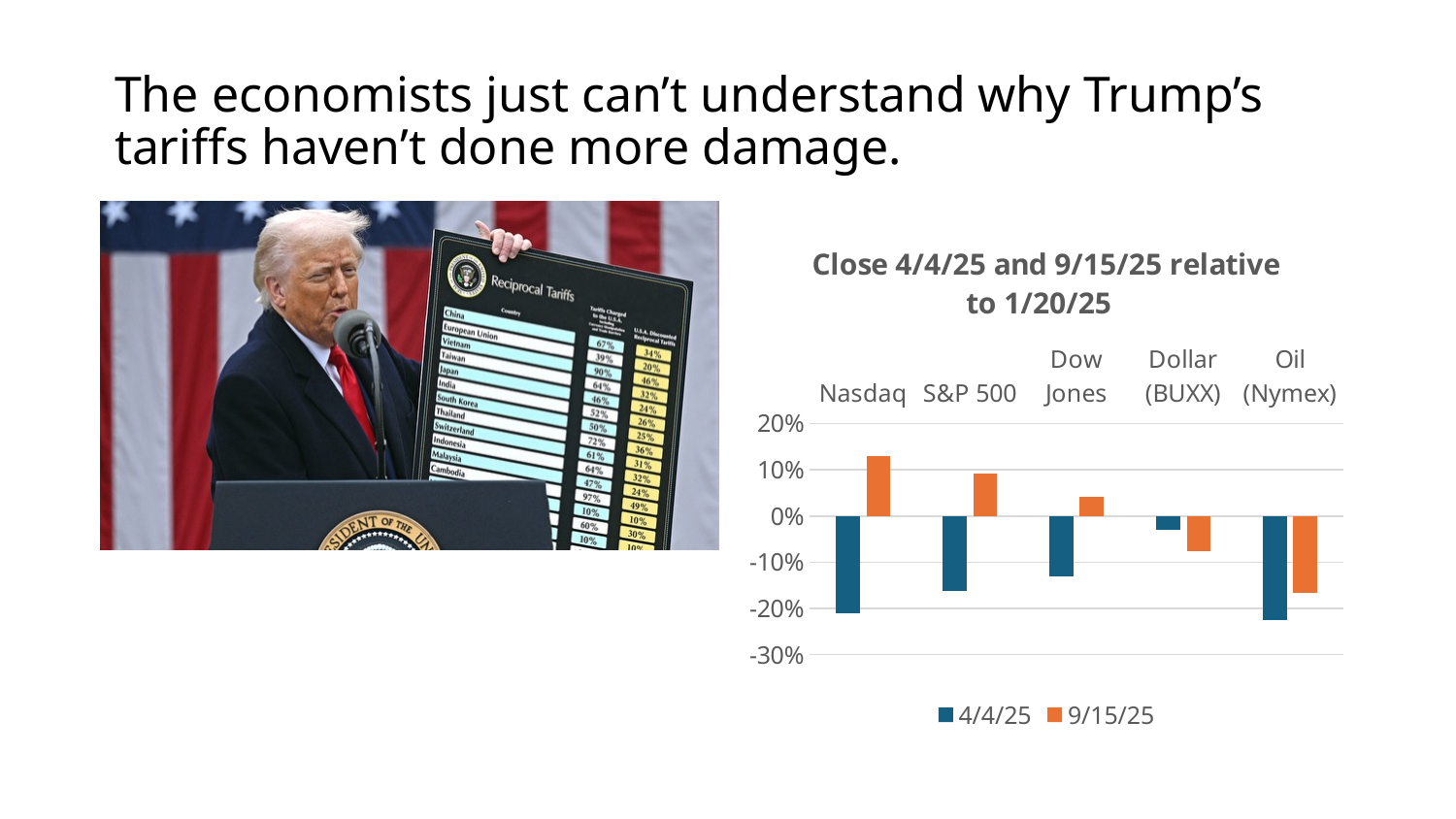
How many categories are plotted on the x axis of the chart? 5 Which series is shown in orange in the chart? 9/15/25 What is the title of the chart? Close 4/4/25 and 9/15/25 relative to 1/20/25 How many series does the chart's legend list? 2 Is the 4/4/25 value for Dollar (BUXX) greater or less than -10%? greater Which category has the lowest 9/15/25 value? Oil (Nymex) Is the 4/4/25 value for S&P 500 greater or less than -10%? less Which category has the highest 9/15/25 value? Nasdaq Is the 9/15/25 value for Nasdaq greater or less than 10%? greater What kind of chart is shown on the slide? bar chart Which category has the highest 4/4/25 value? Dollar (BUXX)